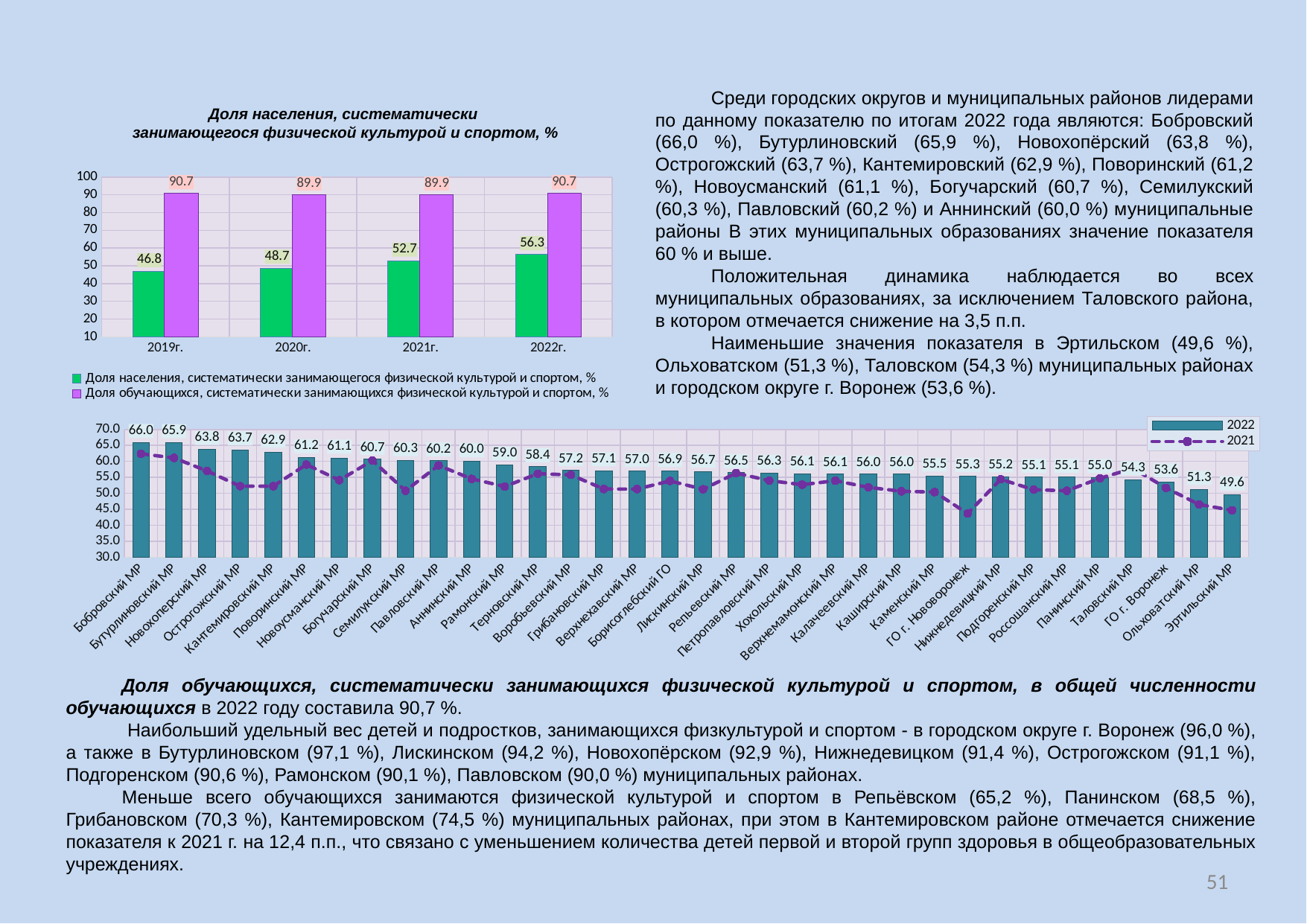
In the top-left chart, how many series does the legend list? 2 In the bottom chart, is the 2021 value for ГО г. Нововоронеж greater or less than 45.0? less In the top-left chart, what is the value for the share of students (обучающихся) systematically engaged in physical culture and sport in 2020? 89.9 In the top-left chart, what is the value for the share of the population systematically engaged in physical culture and sport in 2022? 56.3 In the bottom chart, which has the larger 2022 value, Лискинский МР or Таловский МР? Лискинский МР In the bottom chart, what is the difference between the 2022 values for Бутурлиновский МР and Эртильский МР? 16.3 In the bottom chart, what is the 2022 value for Бобровский МР? 66.0 In the top-left chart, does the share of the population systematically engaged in physical culture and sport rise or fall from 2019 to 2022? rise In the bottom chart, which municipality has the lowest 2022 value? Эртильский МР In the top-left chart, by how much did the share of the population systematically engaged in physical culture and sport increase from 2019 to 2022? 9.5 In the top-left chart, in which year is the share of the population systematically engaged in physical culture and sport lowest? 2019г. In the top-left chart, how many years are shown on the x axis? 4